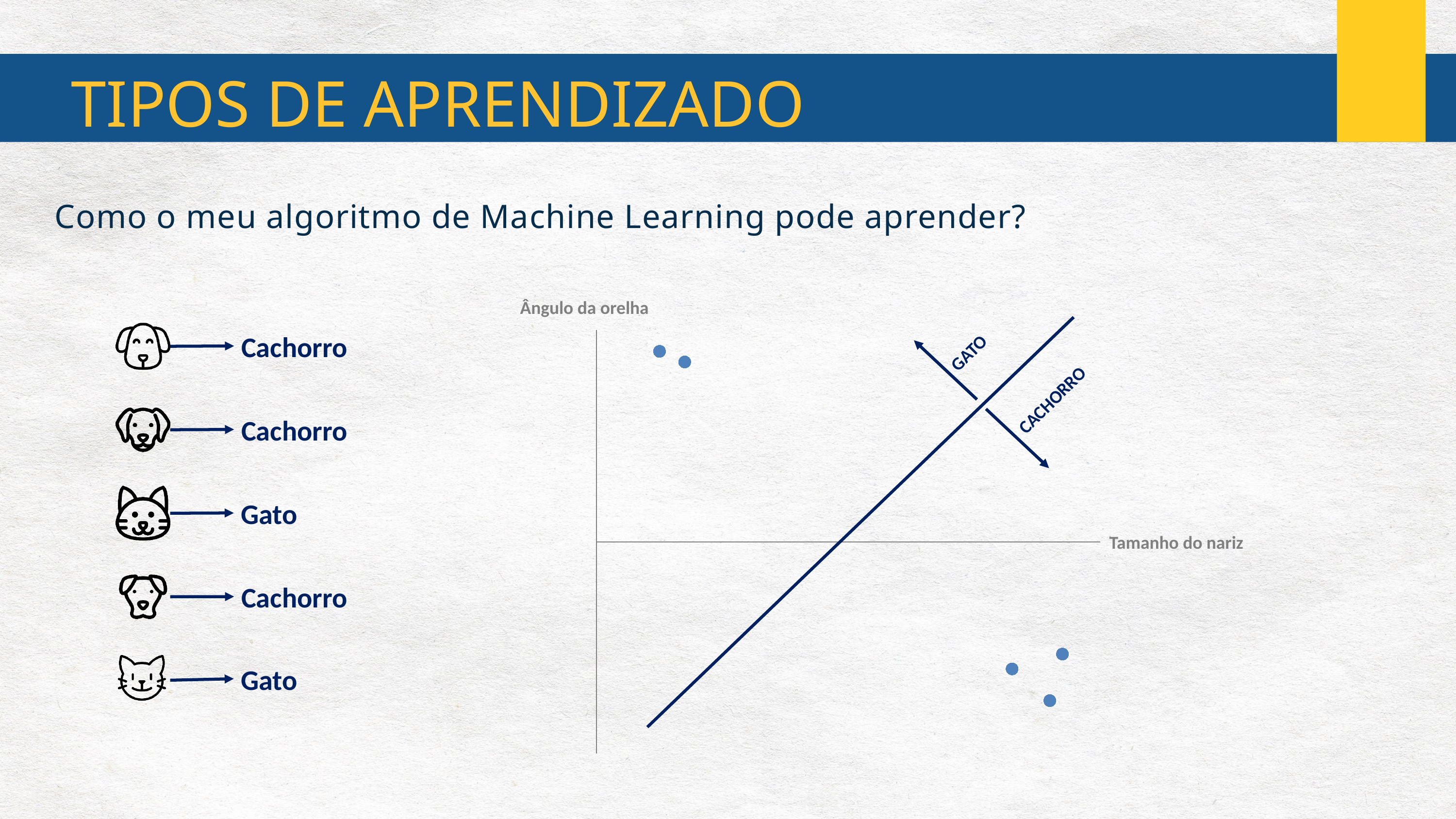
Which class label is written on the side of the diagonal line where the upper-left points are located? GATO How many data points lie below the diagonal dividing line on the scatter chart? 3 Do the points in the lower-right cluster have a higher or lower 'Ângulo da orelha' than the points in the upper-left cluster? lower How many data points are plotted on the scatter chart? 5 How many of the labelled examples on the left are 'Cachorro'? 3 What is the label of the vertical axis of the scatter chart? Ângulo da orelha Which class label is written on the side of the diagonal line where the lower-right points are located? CACHORRO What kind of chart is shown on the right side of the slide? scatter plot What is the label of the horizontal axis of the scatter chart? Tamanho do nariz Do the points in the upper-left cluster have a larger or smaller 'Tamanho do nariz' than the points in the lower-right cluster? smaller